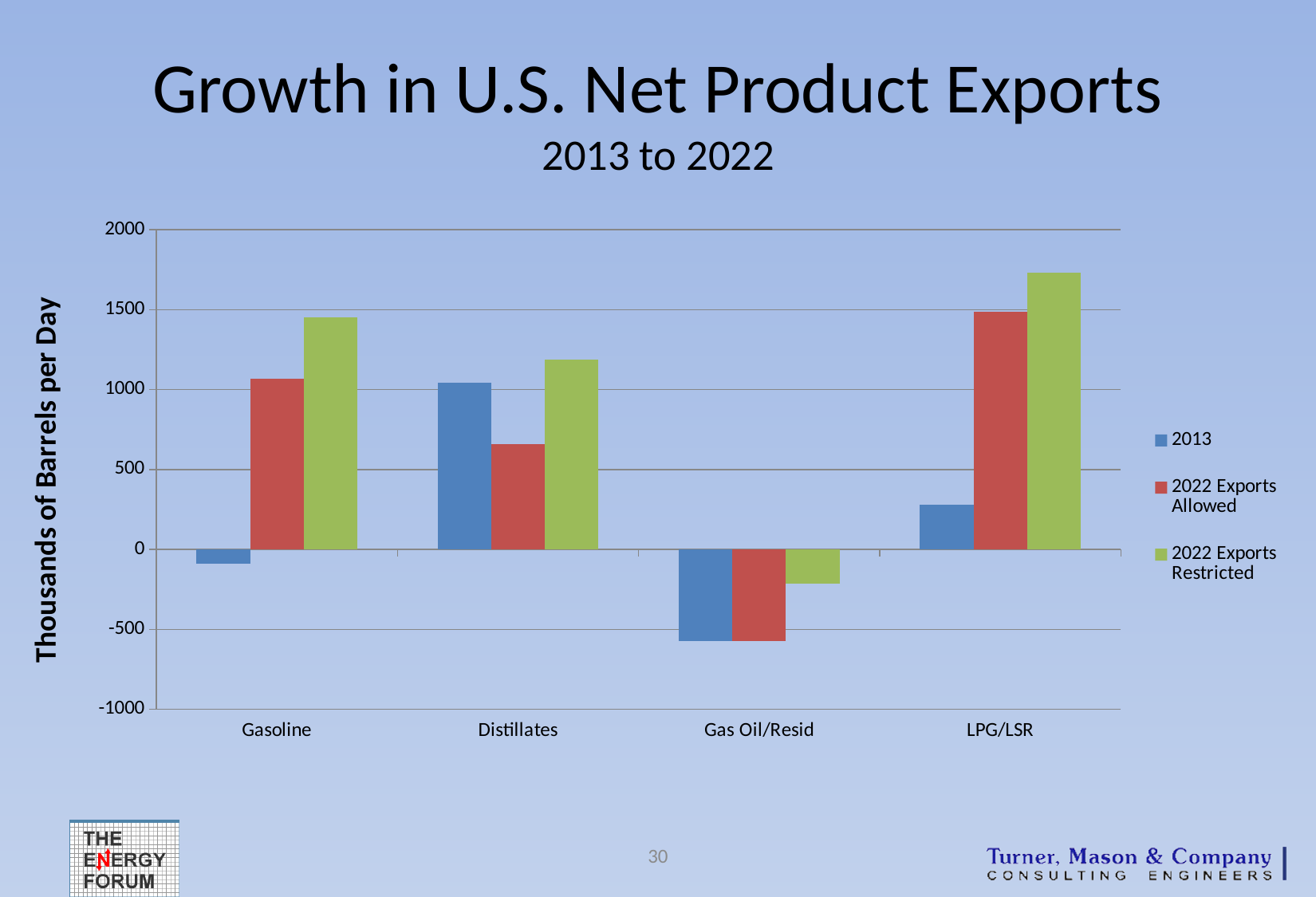
Which category has the lowest value for the 2022 Exports Restricted series? Gas Oil/Resid What is the label on the vertical axis of the chart? Thousands of Barrels per Day Which category has the highest value for the 2013 series? Distillates How many series does the legend list? 3 Which is larger: the 2022 Exports Allowed value for LPG/LSR or for Gasoline? LPG/LSR Is the 2013 value for Gas Oil/Resid greater or less than -500? less How many product categories are shown on the x axis? 4 For Distillates, which is larger: the 2013 value or the 2022 Exports Allowed value? 2013 Is the 2022 Exports Restricted value for Gasoline greater or less than 1000? greater Which category has the highest value for the 2022 Exports Restricted series? LPG/LSR What kind of chart is shown on the slide? Bar chart